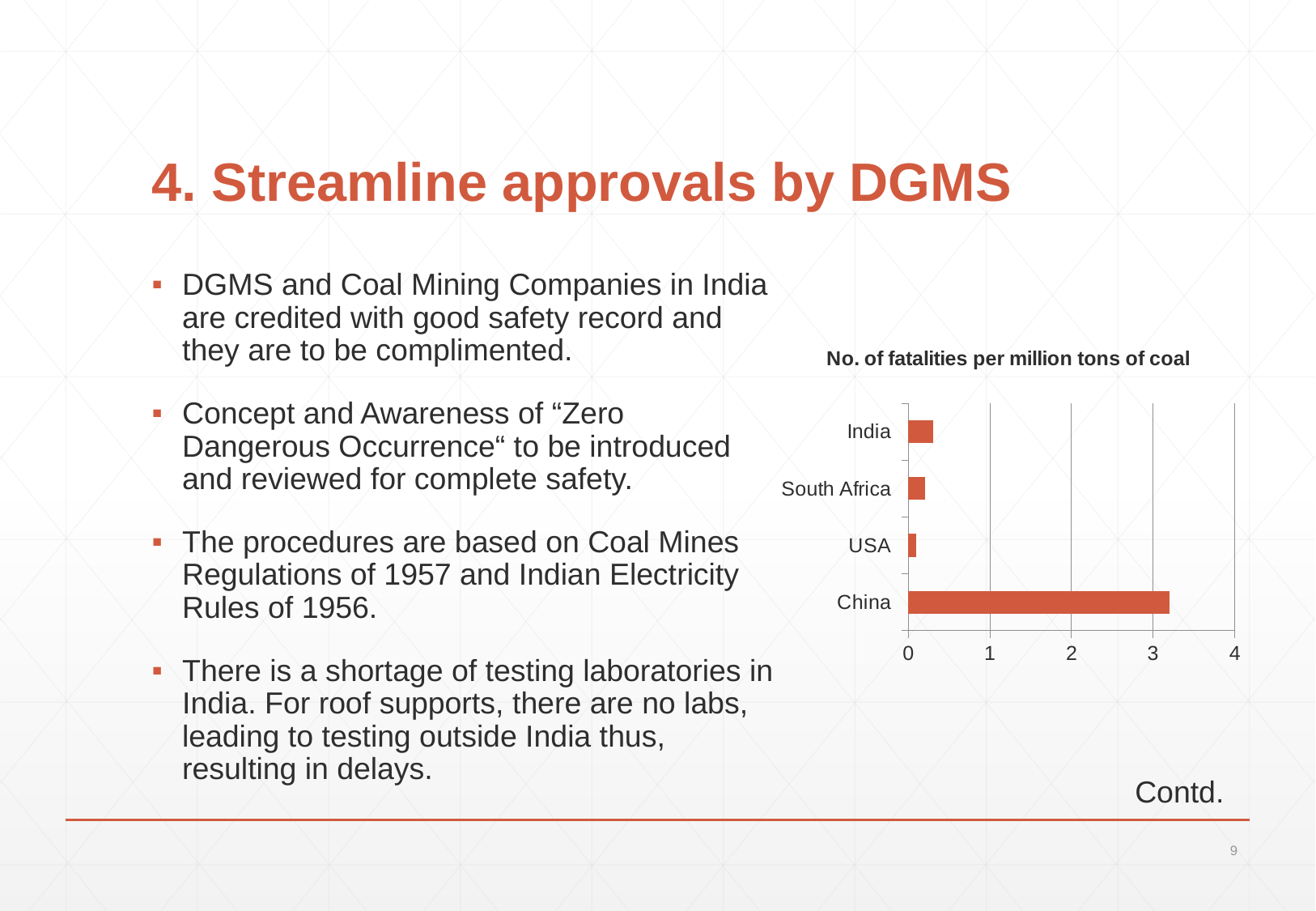
What kind of chart is shown on the slide? bar chart Which country has the lowest number of fatalities per million tons of coal? USA How many countries are shown in the chart? 4 What is the title of the chart? No. of fatalities per million tons of coal What is the maximum value shown on the horizontal axis of the chart? 4 Which country has the highest number of fatalities per million tons of coal? China Is the value for China greater or less than 3? greater Is the value for China greater or less than 4? less Which has a higher value, USA or China? China Which has a higher value, China or India? China Is the value for India greater or less than 1? less